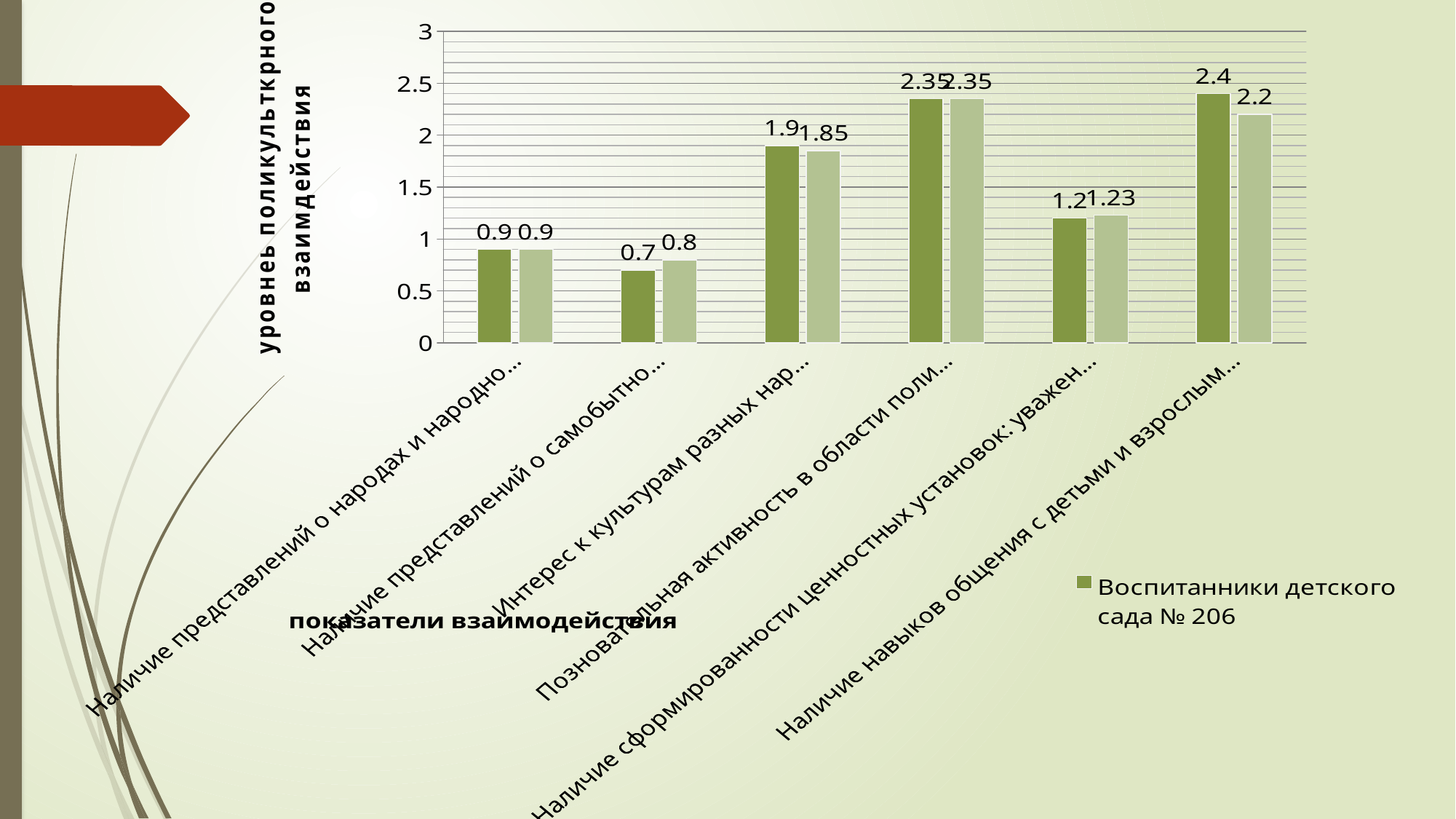
In the category "Наличие представлений о самобытно...", which bar is larger: the dark green bar or the lighter green bar? the lighter green bar How many categories are shown along the x axis of the chart? 6 In which category does "Воспитанники детского сада № 206" (dark green bar) have the lowest value? Наличие представлений о самобытно... What is the value of the lighter green bar in the category "Наличие сформированности ценностных установок: уважен..."? 1.23 What is the title of the vertical axis of the chart? уровнеь поликультурного взаимдействия In which category does "Воспитанники детского сада № 206" (dark green bar) have the highest value? Наличие навыков общения с детьми и взрослым... What is the value of the lighter green bar in the category "Наличие навыков общения с детьми и взрослым..."? 2.2 What type of chart is shown on the slide? bar chart What is the value for "Воспитанники детского сада № 206" (dark green bar) in the category "Интерес к культурам разных нар..."? 1.9 What is the difference between the dark green bar and the lighter green bar in the category "Наличие навыков общения с детьми и взрослым..."? 0.2 Is the value of the dark green bar for "Позновательная активность в области поли..." greater or less than 2? greater What legend entry is shown for the dark green bars? Воспитанники детского сада № 206